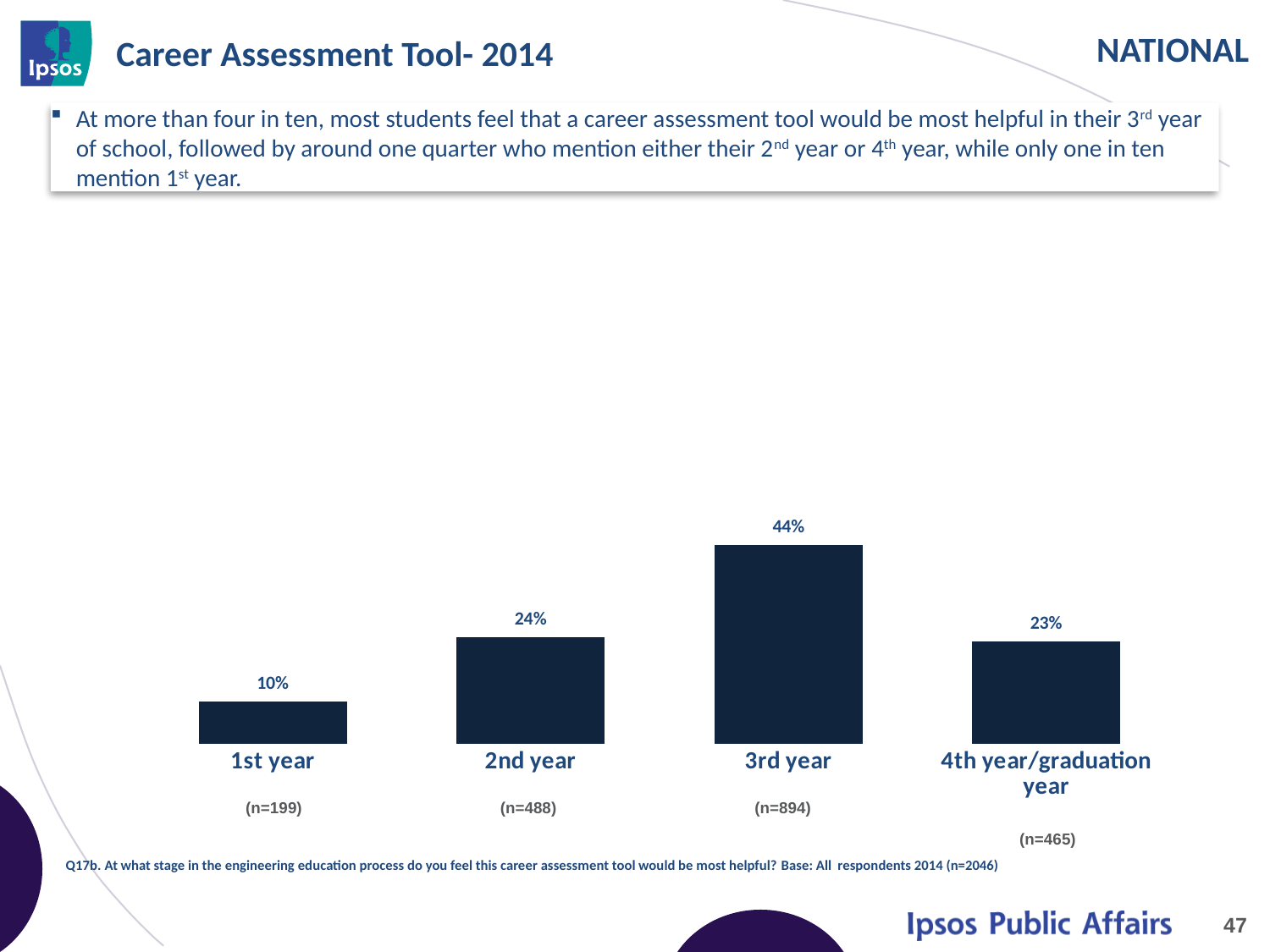
What is the value for 1st year? 10% What is the value for 4th year/graduation year? 23% What is the difference between the values for 3rd year and 2nd year? 20% Which is larger, the value for 3rd year or the value for 4th year/graduation year? 3rd year What is the difference between the values for 2nd year and 1st year? 14% What is the value for 2nd year? 24% Which category has the highest value? 3rd year What is the sample size (n) shown under the 3rd year bar? (n=894) Which category has the lowest value? 1st year What kind of chart is shown on the slide? Bar chart How many categories are shown in the chart? 4 What is the value for 3rd year? 44%